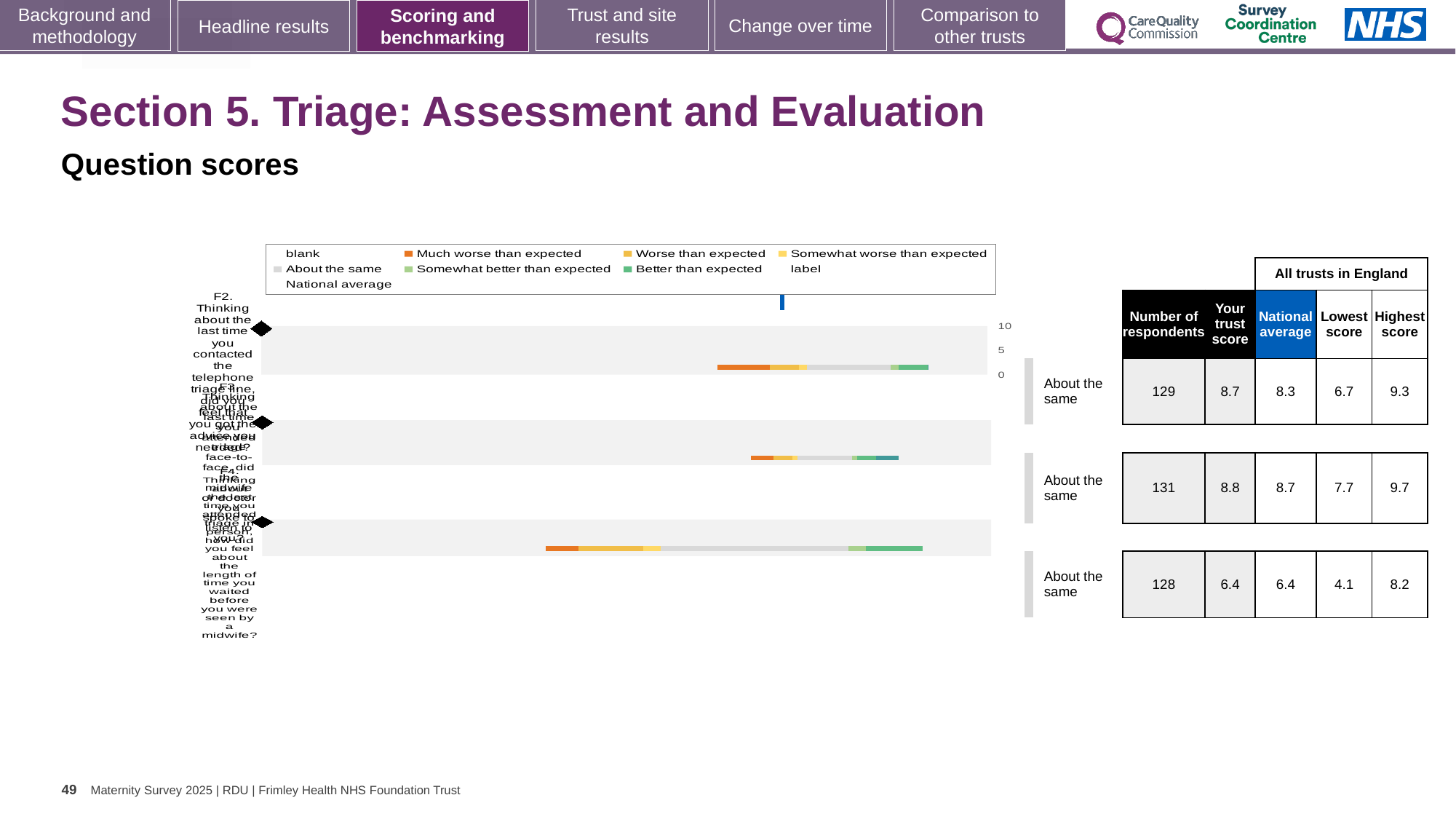
In the table, what is the national average for the third row? 6.4 In the table, what is the 'Your trust score' for the second row? 8.8 In the first row of the table, what is the difference between the highest score and the lowest score? 2.6 In the table, what is the number of respondents for the first row? 129 Which row of the table has the lowest 'Your trust score'? the third row (6.4) What kind of chart is shown on the slide? bar chart Which legend entry is shown in orange? Much worse than expected In the first row of the table, which is larger: the trust score or the national average? the trust score (8.7) In the table, what is the lowest score for the third row? 4.1 Which row of the table has the highest 'Your trust score'? the second row (8.8) What benchmark label is shown next to each of the three bars? About the same How many horizontal bars (question rows) are plotted in the chart? 3